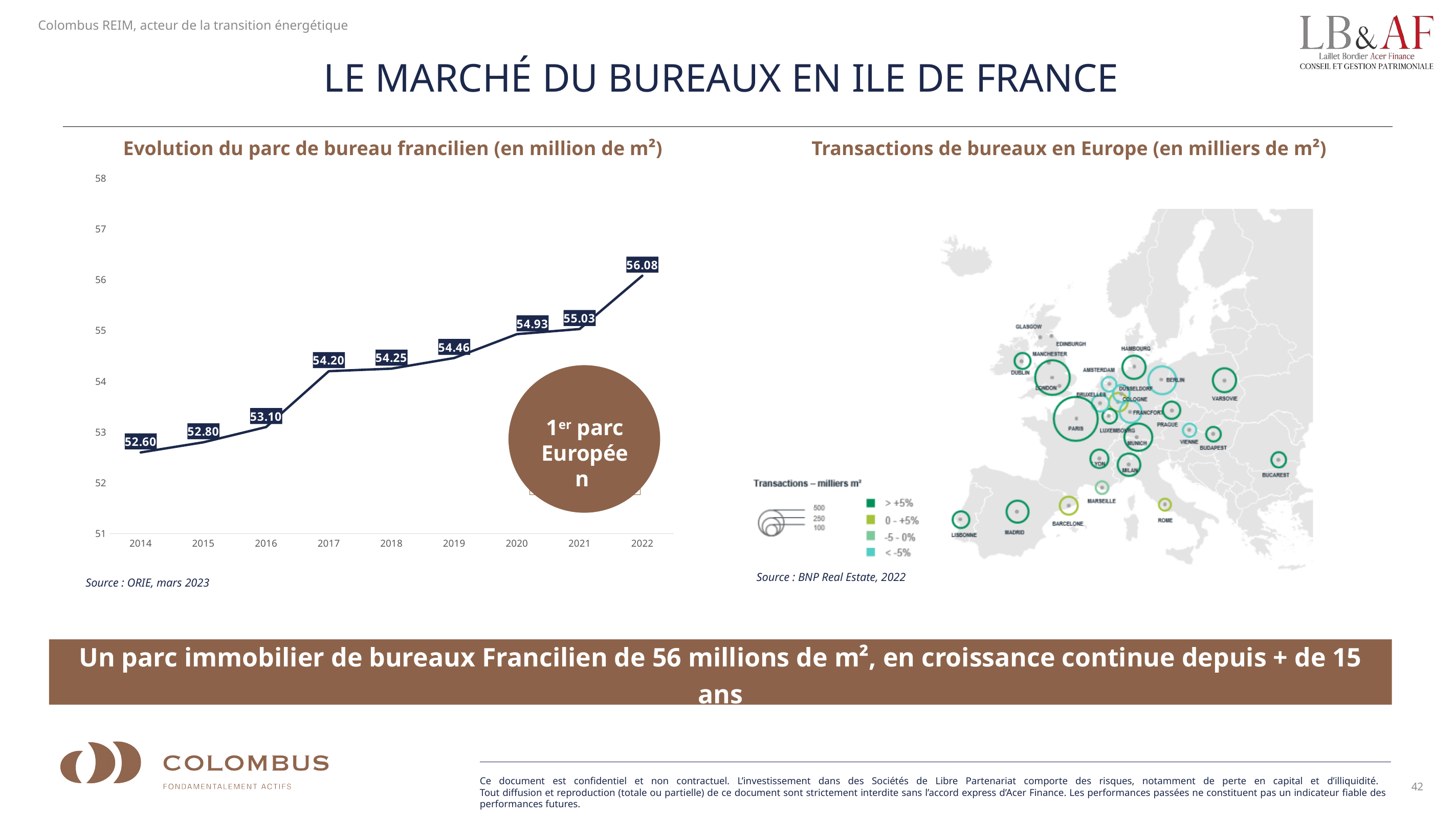
What is the title of the chart on the left side of the slide? Evolution du parc de bureau francilien (en million de m²) In the chart 'Evolution du parc de bureau francilien (en million de m²)', how many years are plotted on the x axis? 9 What kind of chart is 'Evolution du parc de bureau francilien (en million de m²)'? Line chart In the chart 'Evolution du parc de bureau francilien (en million de m²)', what is the value for 2014? 52.60 In the chart 'Evolution du parc de bureau francilien (en million de m²)', do the values rise or fall from 2014 to 2022? Rise In the chart 'Evolution du parc de bureau francilien (en million de m²)', what is the value for 2019? 54.46 In the chart 'Evolution du parc de bureau francilien (en million de m²)', which year has the highest value? 2022 In the chart 'Evolution du parc de bureau francilien (en million de m²)', which year has the lowest value? 2014 In the chart 'Evolution du parc de bureau francilien (en million de m²)', what is the difference between the 2022 value and the 2014 value? 3.48 In the chart 'Evolution du parc de bureau francilien (en million de m²)', what is the difference between the 2017 value and the 2016 value? 1.10 In the chart 'Evolution du parc de bureau francilien (en million de m²)', what is the value for 2022? 56.08 In the chart 'Evolution du parc de bureau francilien (en million de m²)', which is larger, the value for 2020 or the value for 2018? 2020